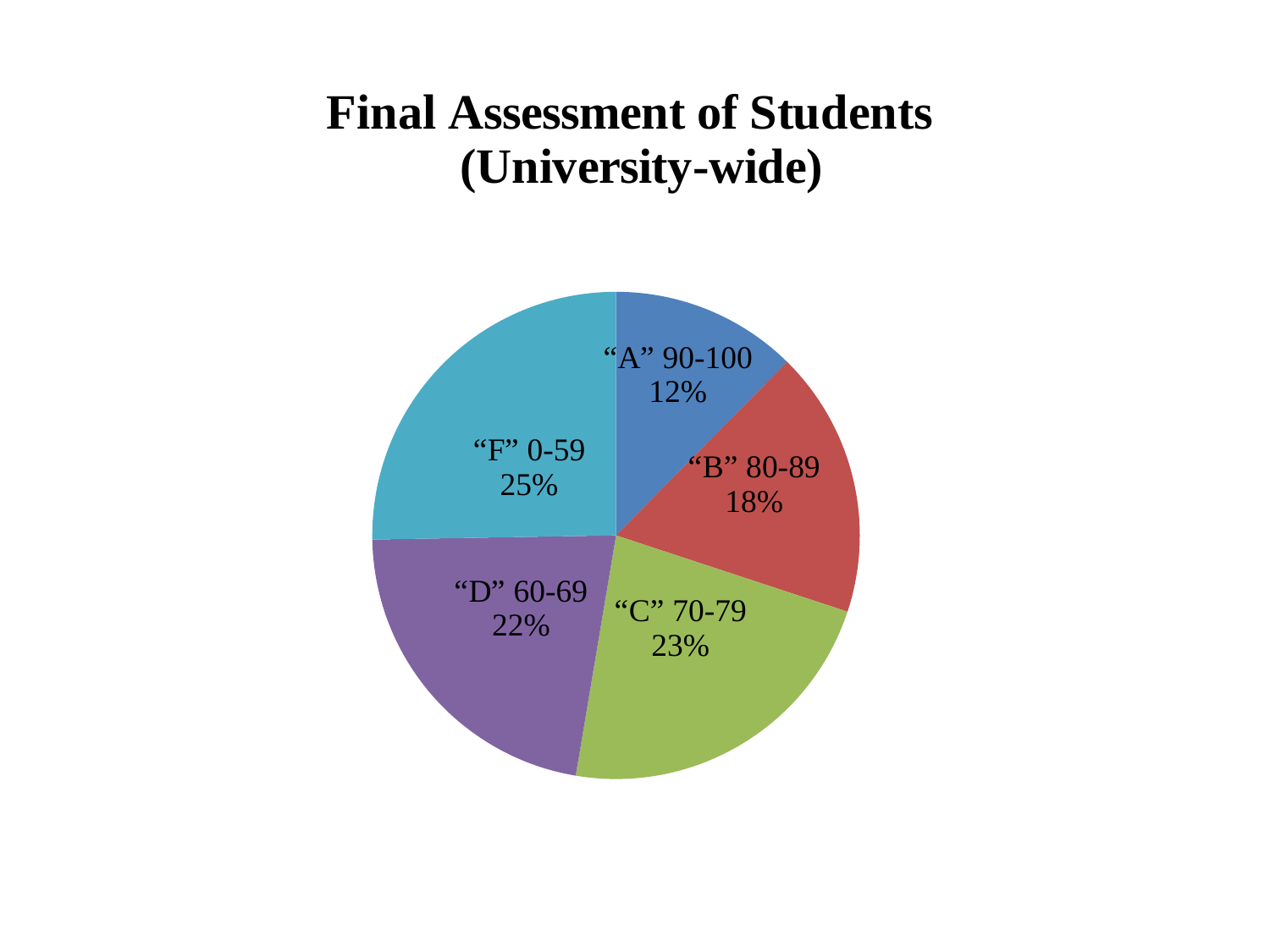
What is the title of the chart? Final Assessment of Students (University-wide) How many grade categories are shown in the pie chart? 5 What percentage of students received an "A" (90-100)? 12% What type of chart is shown on the slide? Pie chart What percentage of students received a "C" (70-79)? 23% What percentage of students received a "D" (60-69)? 22% What percentage of students received a "B" (80-89)? 18% What is the difference in percentage points between the "F" and "A" categories? 13 Which has a larger share, "B" 80-89 or "D" 60-69? "D" 60-69 Which grade category has the smallest share of students? "A" 90-100 What percentage of students received an "F" (0-59)? 25% Which grade category has the largest share of students? "F" 0-59